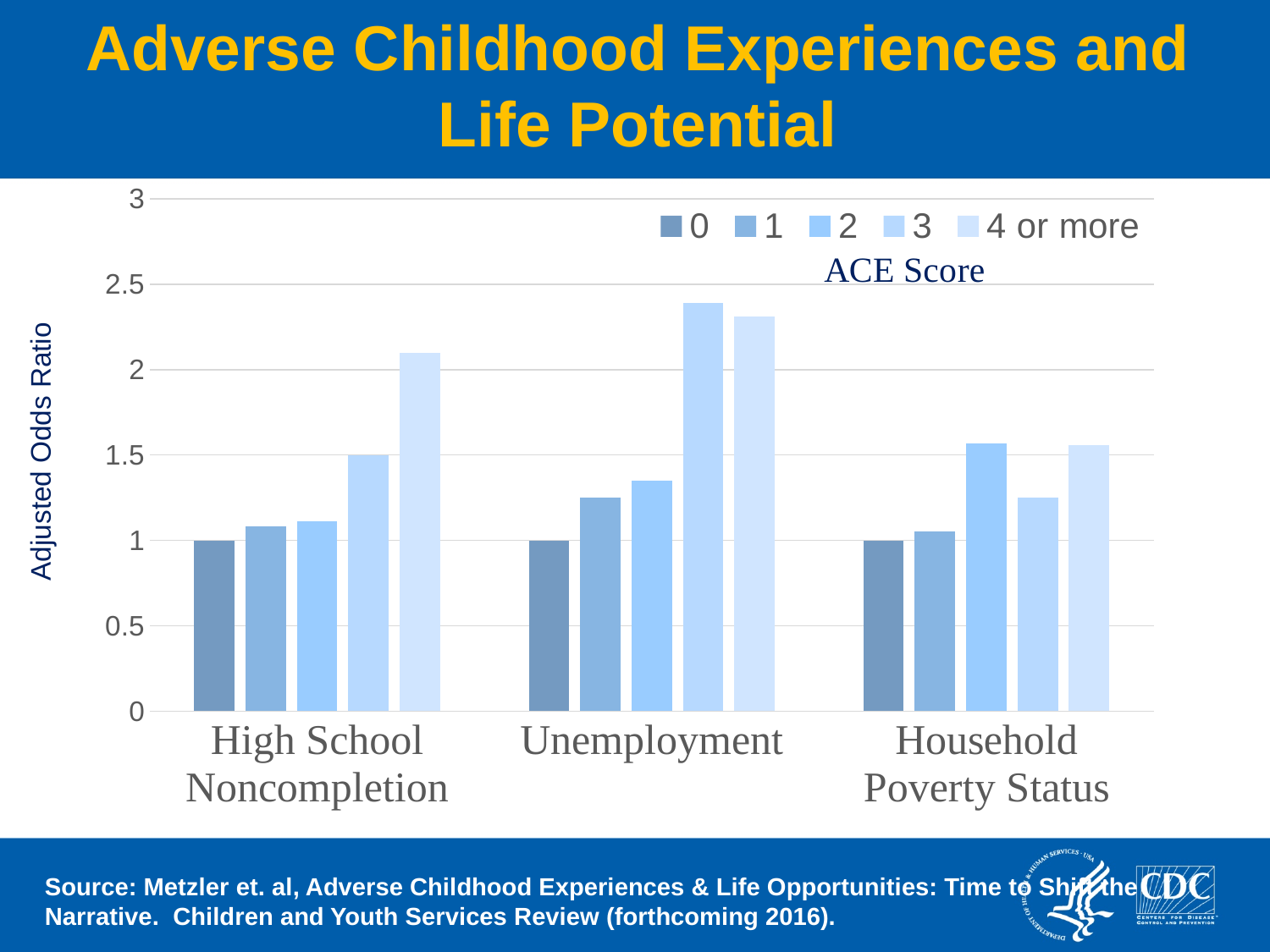
What is the adjusted odds ratio for an ACE score of 0 in the Unemployment category? 1 What is the title of the y axis? Adjusted Odds Ratio How many categories are shown along the x axis? 3 How many series does the legend list? 5 Which ACE score has the highest adjusted odds ratio for Unemployment? 3 Which ACE score has the highest adjusted odds ratio for High School Noncompletion? 4 or more Which is larger: the value for ACE score 3 in Unemployment or the value for ACE score 4 or more in High School Noncompletion? ACE score 3 in Unemployment What kind of chart is shown on the slide? bar chart Is the value for ACE score 3 in the Household Poverty Status category greater or less than 1.5? less Which ACE score has the lowest adjusted odds ratio for Household Poverty Status? 0 What is the title shown for the legend? ACE Score Is the value for ACE score 4 or more in the Unemployment category greater or less than 2? greater